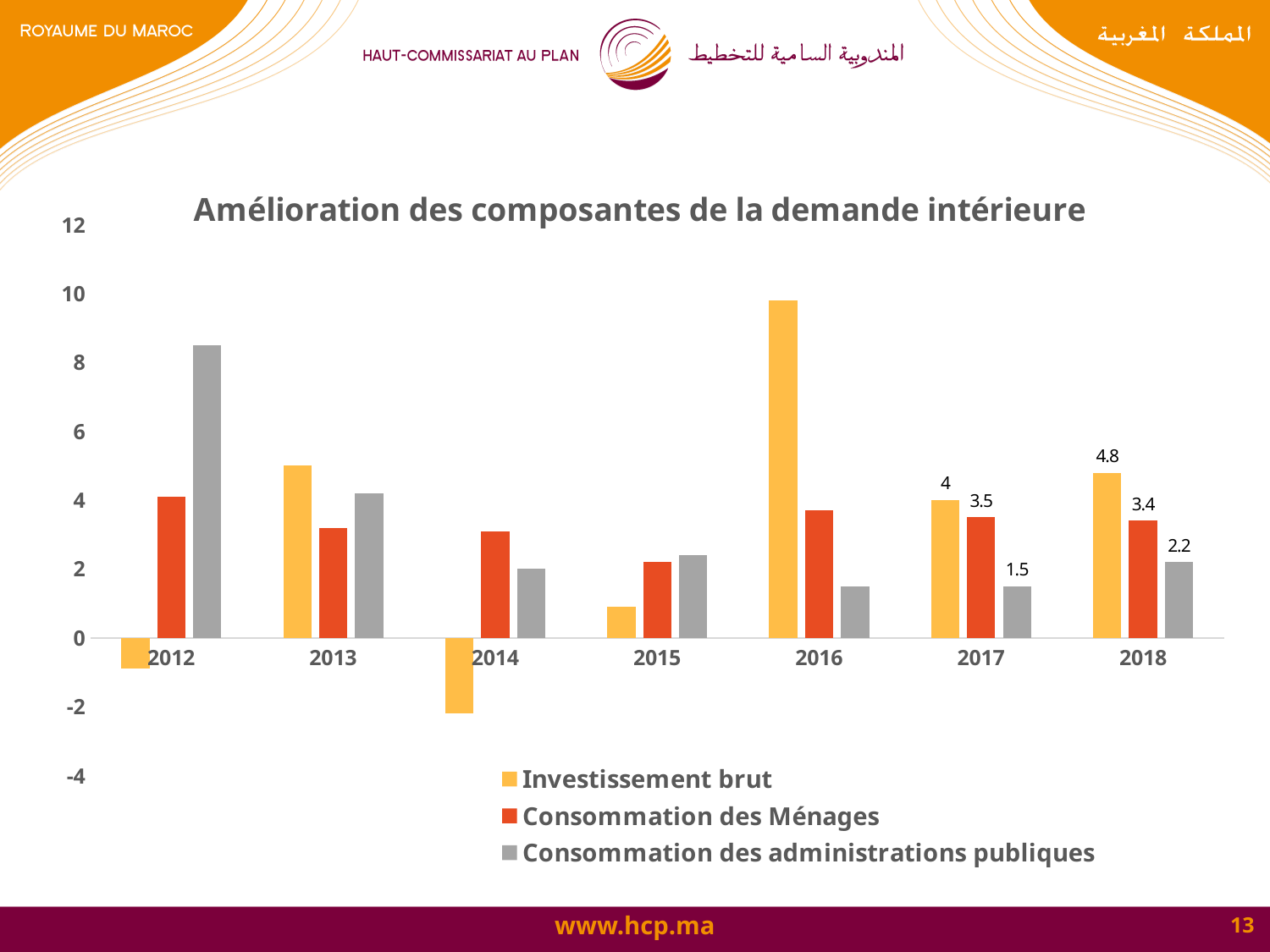
Is the value of Investissement brut in 2014 greater or less than 0? less What type of chart is shown on the slide? bar chart What is the value of Investissement brut in 2017? 4 What is the value of Investissement brut in 2018? 4.8 How many series does the legend list? 3 Is the value of Investissement brut in 2016 greater or less than 8? greater In which year is Investissement brut the highest? 2016 How many years are shown on the x axis? 7 What is the value of Consommation des Ménages in 2017? 3.5 Which series has the highest value in 2012? Consommation des administrations publiques What is the value of Consommation des administrations publiques in 2018? 2.2 What is the difference between Investissement brut and Consommation des Ménages in 2018? 1.4